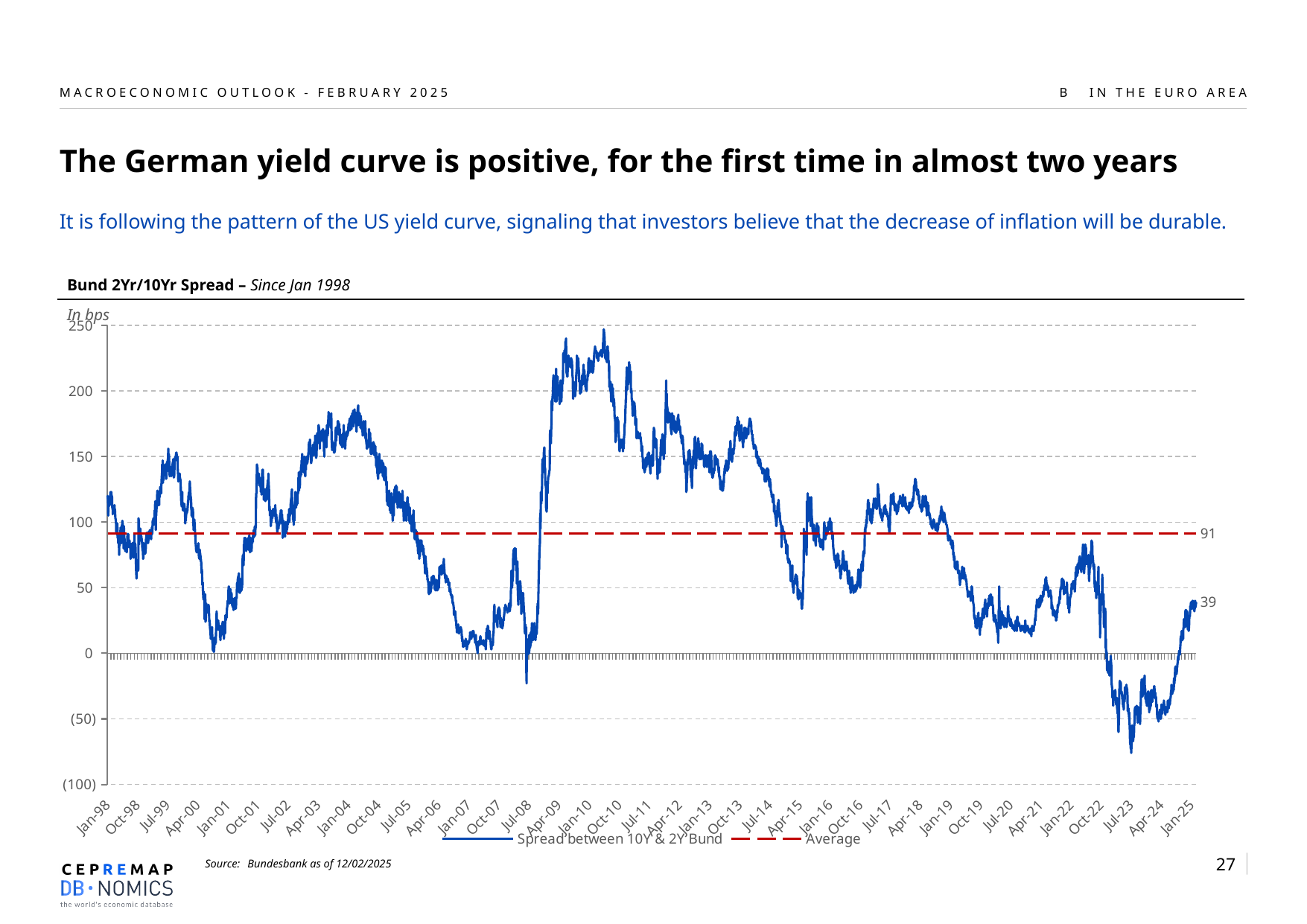
What is the value of the Average line shown on the chart? 91 Is the spread around Jan-04 greater or less than 150? greater What is the difference between the Average (91) and the latest spread value (39)? 52 Does the spread rise or fall between Jul-23 and Jan-25? rise What unit is the y axis of the chart expressed in? bps How many series does the legend list? 2 What is the latest value of the spread between 10Y & 2Y Bund, labelled at the right end of the line? 39 Is the spread around Jul-23 greater or less than 0? less Is the spread around Oct-10 greater or less than 200? greater Around which x-axis label does the spread reach its lowest point? Jul-23 What kind of chart is shown on the slide? line chart Which is larger: the latest spread value or the Average? Average